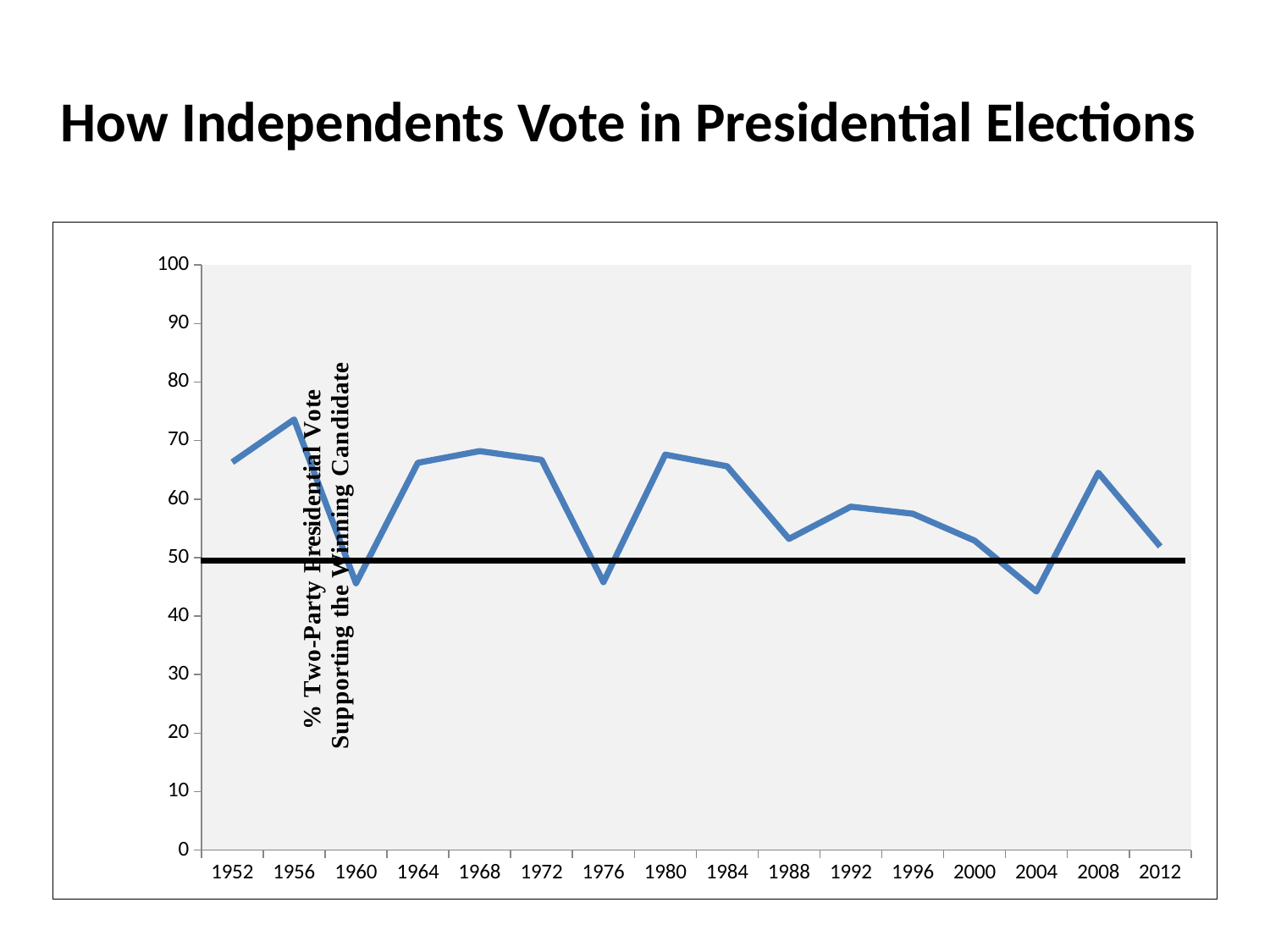
What is the title of the slide's chart? How Independents Vote in Presidential Elections Is the value for 1960 greater or less than 50? less In which election year is the percentage of independents supporting the winning candidate highest? 1956 What kind of chart is shown on the slide? line chart Does the line rise or fall from 2008 to 2012? fall Is the value for 1956 greater or less than 70? greater What is the label on the vertical axis of the chart? % Two-Party Presidential Vote Supporting the Winning Candidate Is the value for 2004 greater or less than 50? less Which year has the larger value, 1956 or 1960? 1956 Which year has the larger value, 1980 or 1988? 1980 How many election years are plotted on the x axis? 16